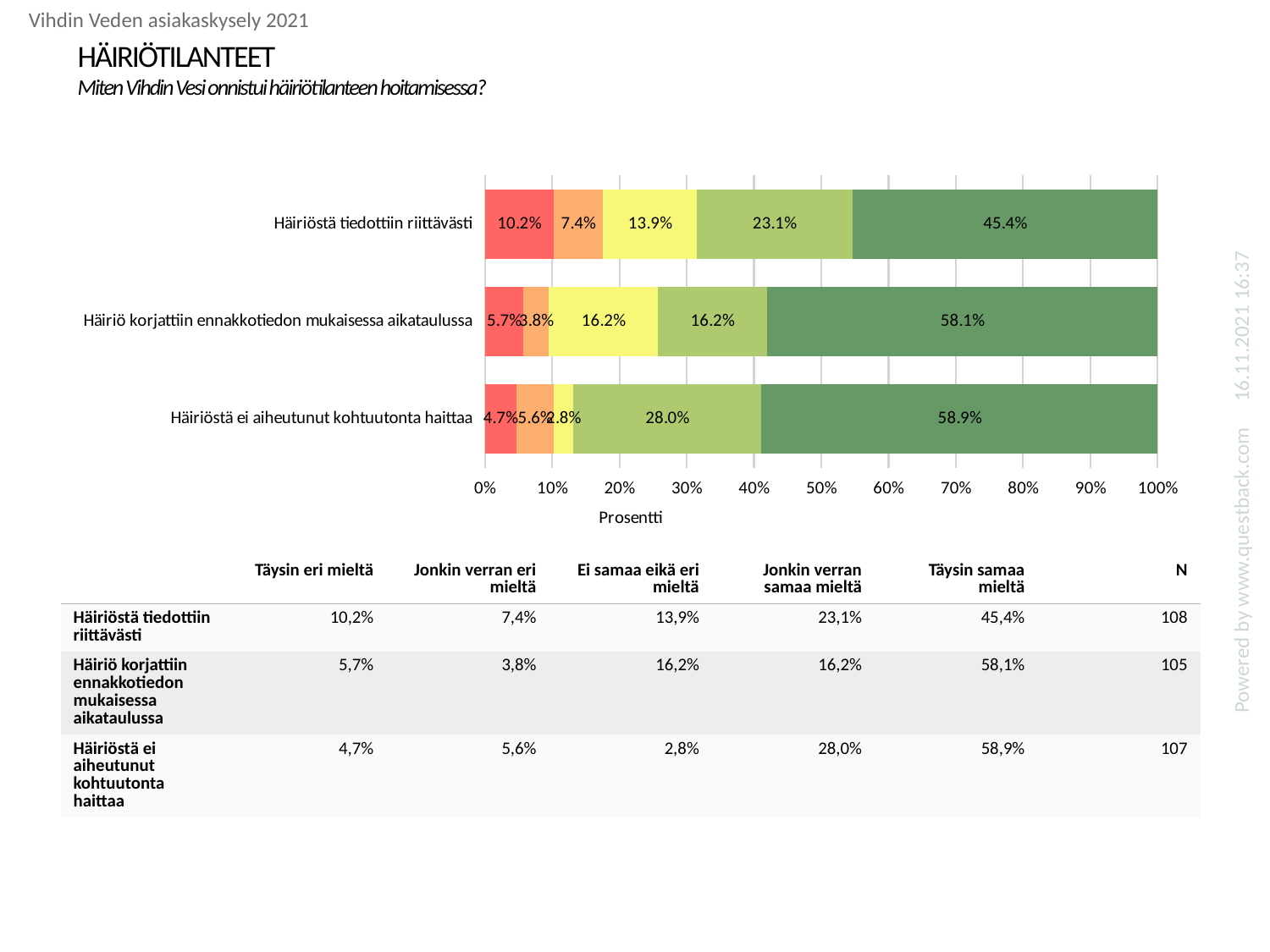
What type of chart is shown on the slide? Stacked bar chart Which statement has the lowest 'Täysin eri mieltä' share? Häiriöstä ei aiheutunut kohtuutonta haittaa What percentage of respondents answered 'Täysin samaa mieltä' for 'Häiriöstä tiedottiin riittävästi'? 45.4% What is the title of the horizontal axis of the chart? Prosentti Which statement has the larger 'Ei samaa eikä eri mieltä' share: 'Häiriöstä tiedottiin riittävästi' or 'Häiriö korjattiin ennakkotiedon mukaisessa aikataulussa'? Häiriö korjattiin ennakkotiedon mukaisessa aikataulussa What is the 'Jonkin verran samaa mieltä' share for 'Häiriöstä ei aiheutunut kohtuutonta haittaa'? 28.0% What is the 'Täysin samaa mieltä' share for 'Häiriö korjattiin ennakkotiedon mukaisessa aikataulussa'? 58.1% What is the 'Jonkin verran eri mieltä' share for 'Häiriöstä tiedottiin riittävästi'? 7.4% Which statement has the highest 'Täysin samaa mieltä' share? Häiriöstä ei aiheutunut kohtuutonta haittaa Is the 'Täysin samaa mieltä' share for 'Häiriöstä tiedottiin riittävästi' greater or less than 40%? greater For 'Häiriöstä tiedottiin riittävästi', how many percentage points larger is the 'Täysin samaa mieltä' share than the 'Jonkin verran samaa mieltä' share? 22.3 How many statements (bars) are shown in the chart? 3